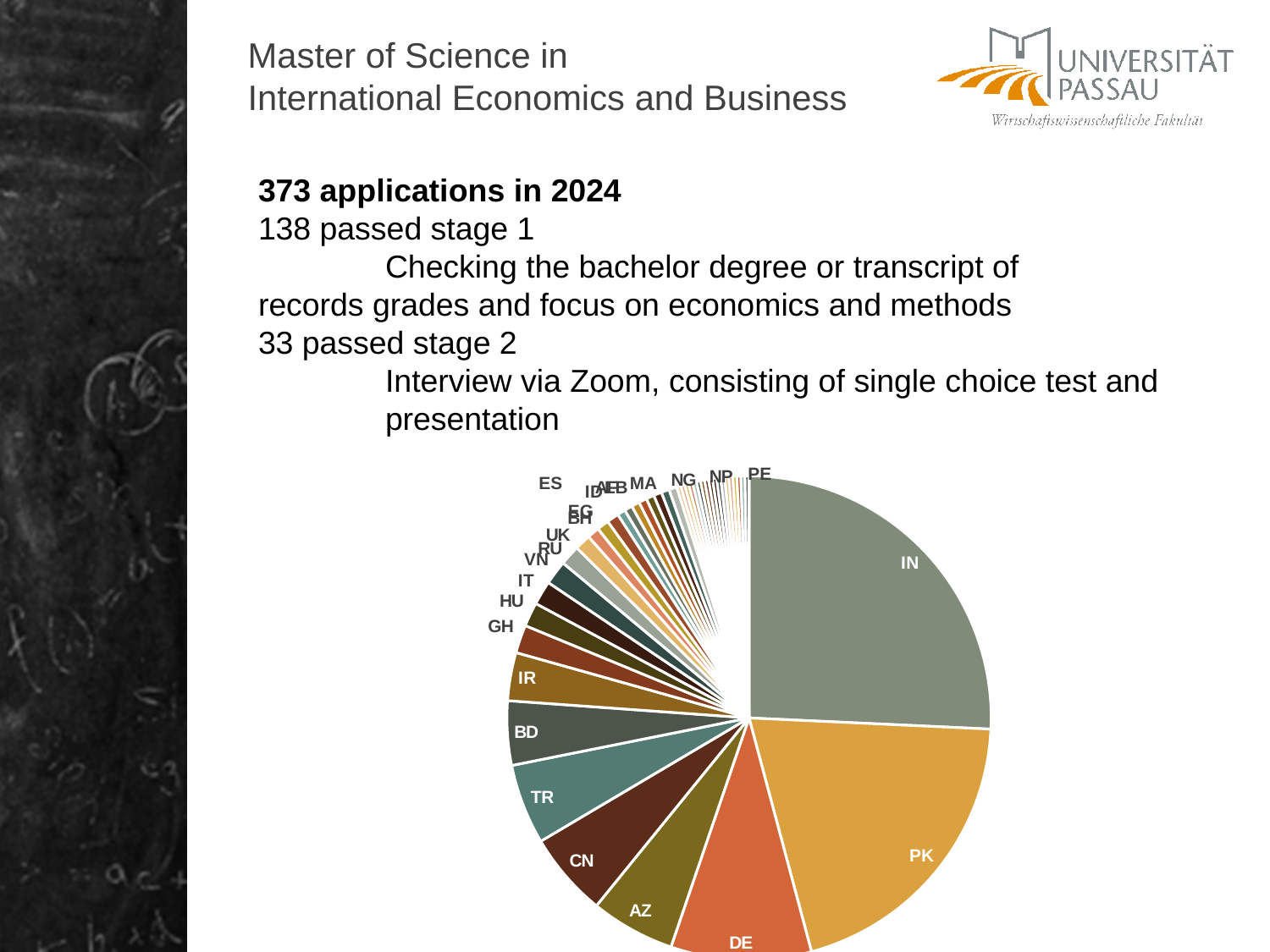
Which slice is larger in the pie chart, IN or CN? IN Which slice is larger in the pie chart, PK or TR? PK What colour is the PK slice of the pie chart? orange-gold Which slice is larger in the pie chart, DE or IR? DE What colour is the IN slice of the pie chart? grey-green What kind of chart is shown on the slide? pie chart Which category has the largest slice of the pie chart? IN